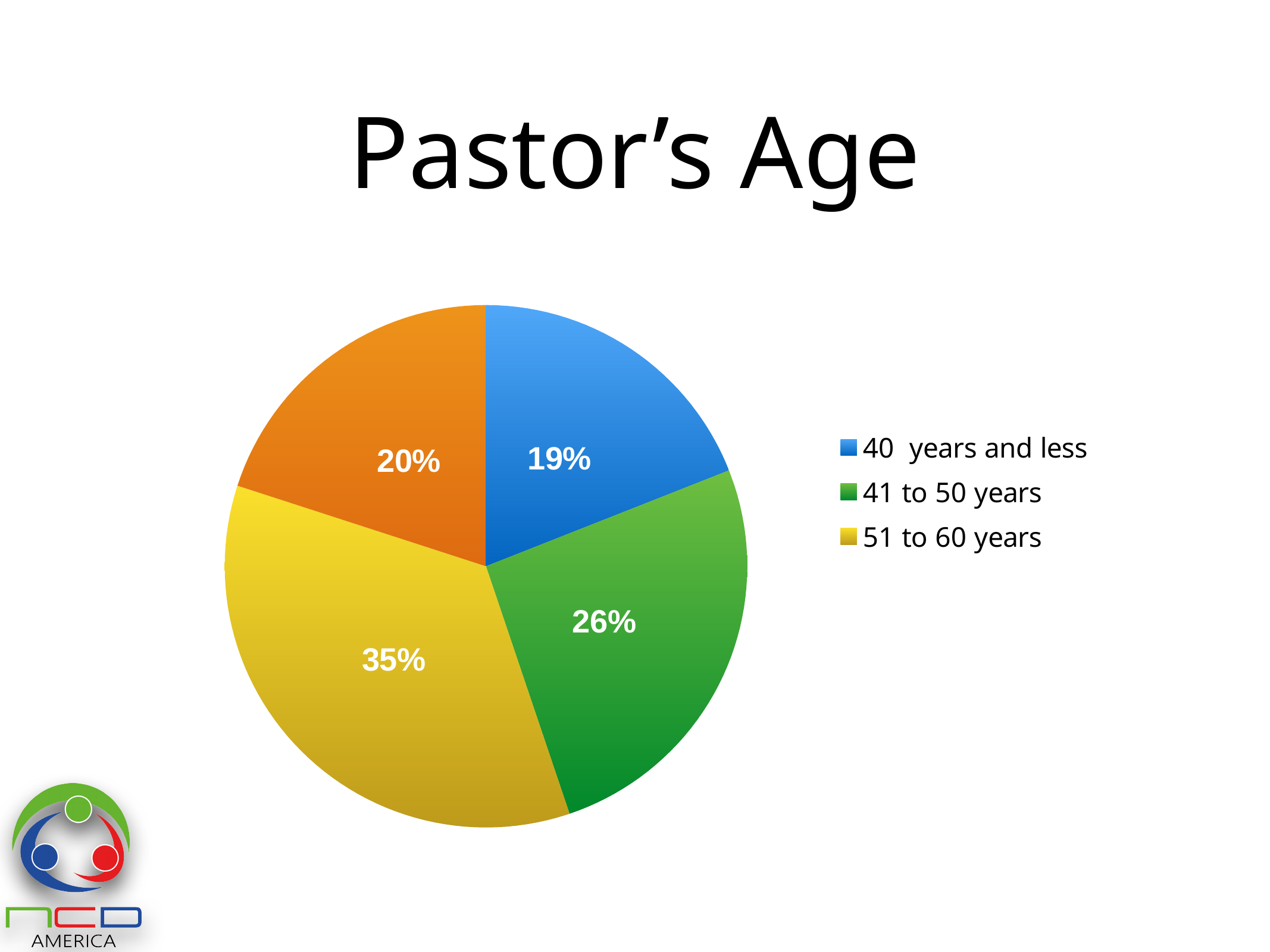
How many slices does the pie chart have? 4 Which age group has the largest slice of the pie? 51 to 60 years Which age group has the smallest slice of the pie? 40 years and less Which slice is larger, 41 to 50 years or 40 years and less? 41 to 50 years What share of the pie is the 40 years and less slice? 19% What is the title of the chart? Pastor's Age How many entries does the legend list? 3 What colour is the 51 to 60 years slice? yellow What share of the pie is the 51 to 60 years slice? 35% What kind of chart is shown on the slide? pie chart What is the difference in percentage points between the 51 to 60 years slice and the 41 to 50 years slice? 9 What share of the pie is the 41 to 50 years slice? 26%